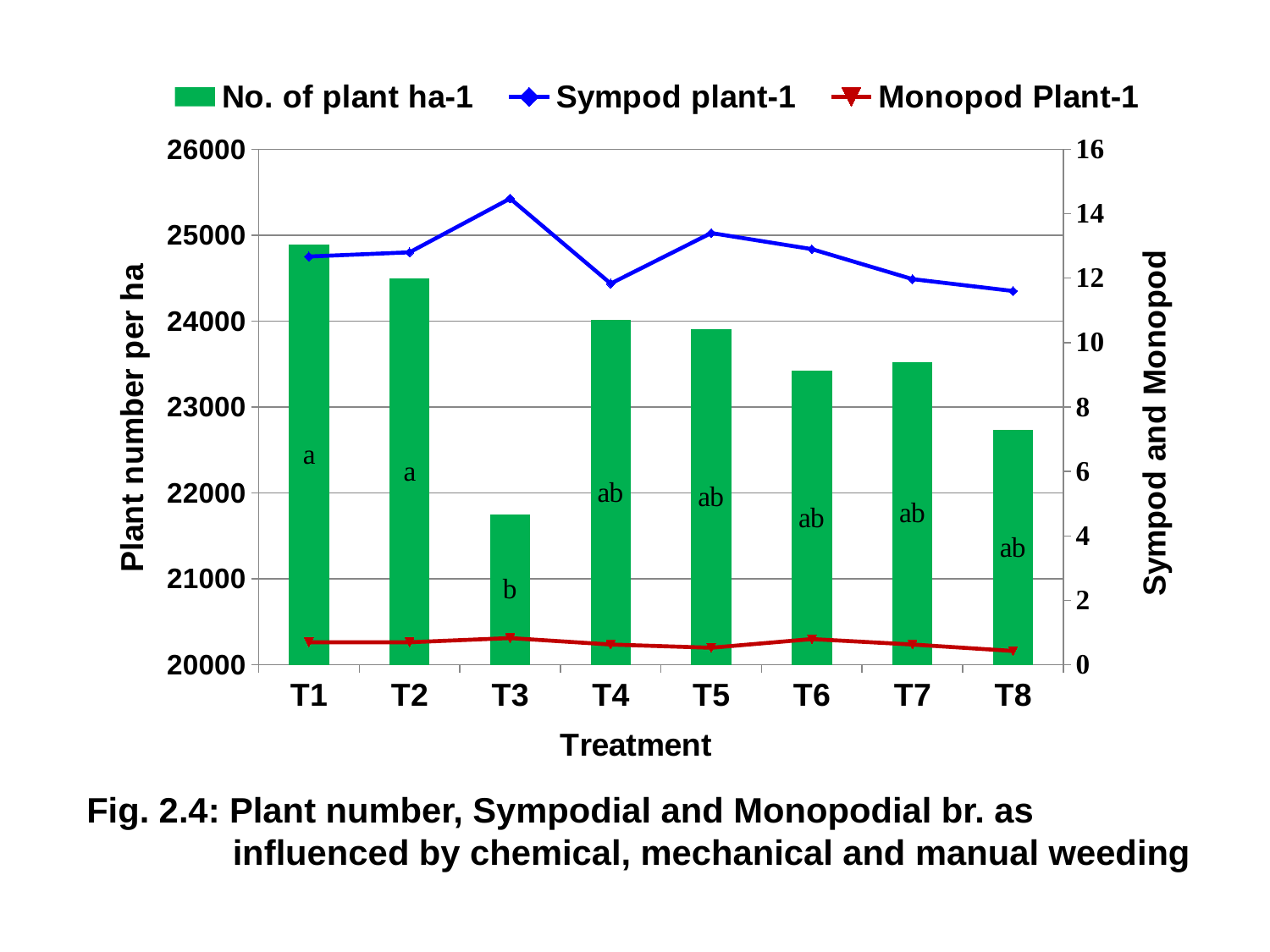
Which treatment has the highest number of plants per ha (green bars)? T1 Which has a larger Sympod plant-1 value, T3 or T4? T3 What letter label is printed on the bar for T3? b What kind of chart is shown on the slide? A combined bar and line chart Which treatment has the lowest number of plants per ha (green bars)? T3 Is the number of plants per ha for T3 greater or less than 22000? less How many series does the legend list? 3 Which treatment has the highest value for Sympod plant-1 (blue line)? T3 Is the Sympod plant-1 value for T3 greater or less than 14? greater Is the number of plants per ha for T1 greater or less than 24000? greater How many treatments are shown on the x axis? 8 Which has a larger number of plants per ha, T4 or T8? T4